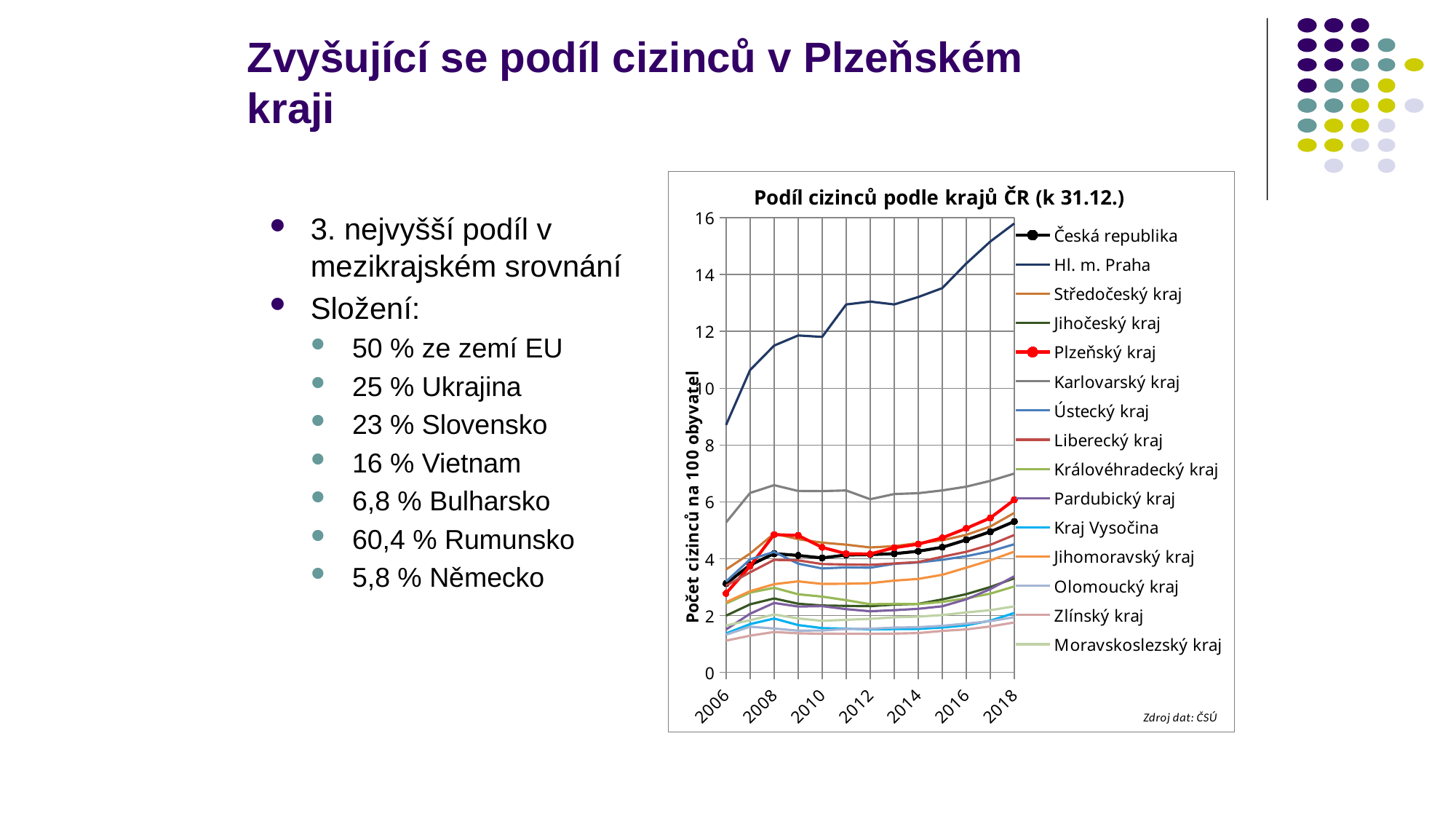
Does the value for Hl. m. Praha rise or fall from 2006 to 2018? rise In 2012, which is larger: Karlovarský kraj or Plzeňský kraj? Karlovarský kraj Is the value for Hl. m. Praha in 2018 greater or less than 14? greater Is the value for Česká republika in 2018 greater or less than 6? less What kind of chart is shown on the slide? line chart Is the value for Karlovarský kraj in 2018 greater or less than 6? greater In 2018, which is larger: Plzeňský kraj or Česká republika? Plzeňský kraj How many series does the chart legend list? 15 Which series has the highest value in 2018? Hl. m. Praha What is the title of the chart? Podíl cizinců podle krajů ČR (k 31.12.) What is the label of the vertical axis of the chart? Počet cizinců na 100 obyvatel